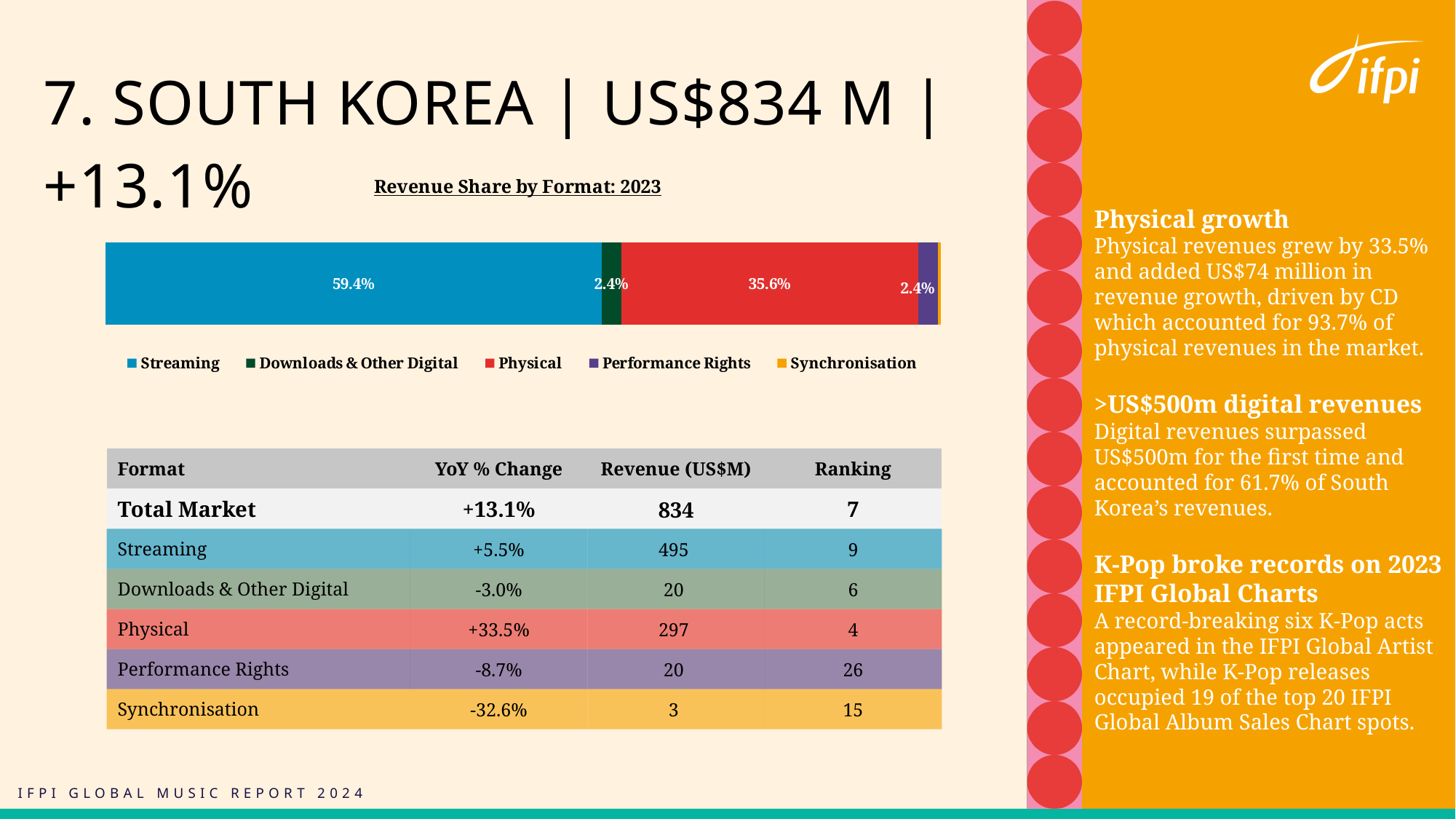
In the Revenue Share by Format chart, what colour represents Physical? Red In the Revenue Share by Format chart, which is larger, the Physical share or the Streaming share? Streaming In the Revenue Share by Format chart, which format has the largest share? Streaming In the Revenue Share by Format chart, what share is shown for Performance Rights? 2.4% How many formats does the legend of the Revenue Share by Format chart list? 5 What kind of chart is shown under the title "Revenue Share by Format: 2023"? Stacked bar chart What is the title of the chart on the slide? Revenue Share by Format: 2023 In the Revenue Share by Format chart, what share is shown for Physical? 35.6% In the Revenue Share by Format chart, what share is shown for Downloads & Other Digital? 2.4% In the Revenue Share by Format chart, what share is shown for Streaming? 59.4% In the Revenue Share by Format chart, how many percentage points larger is the Streaming share than the Physical share? 23.8 In the Revenue Share by Format chart, which format has the smallest share? Synchronisation